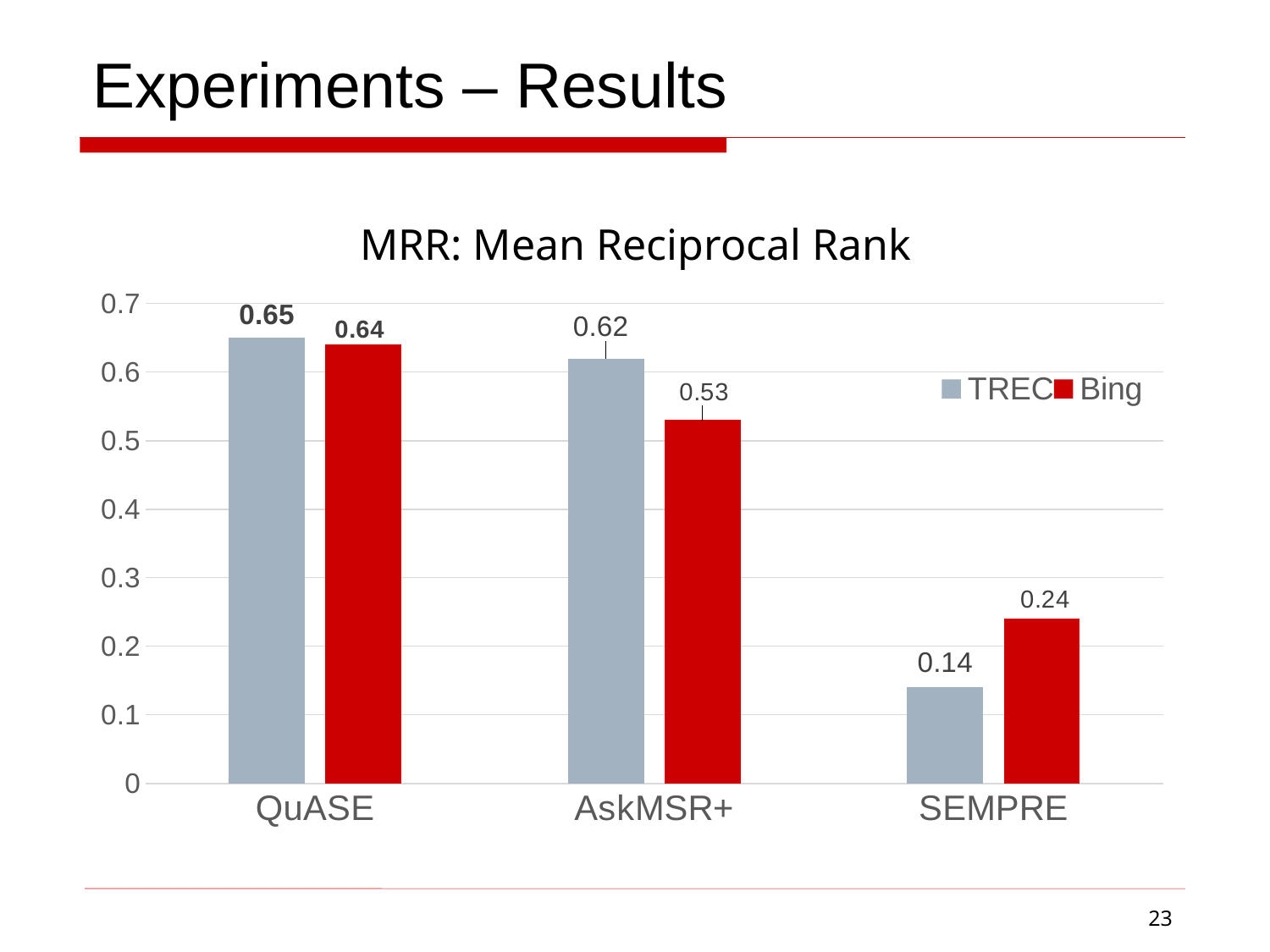
What kind of chart is shown? bar chart How many systems are shown on the x axis? 3 For SEMPRE, which is larger, the TREC value or the Bing value? Bing What is the difference between the TREC and Bing values for AskMSR+? 0.09 Is the TREC value for AskMSR+ greater or less than 0.5? greater What is the TREC value for SEMPRE? 0.14 What is the TREC value for QuASE? 0.65 How many series does the legend list? 2 What is the difference between the Bing values for QuASE and SEMPRE? 0.40 What is the Bing value for AskMSR+? 0.53 Which system has the highest TREC value? QuASE Which system has the lowest Bing value? SEMPRE